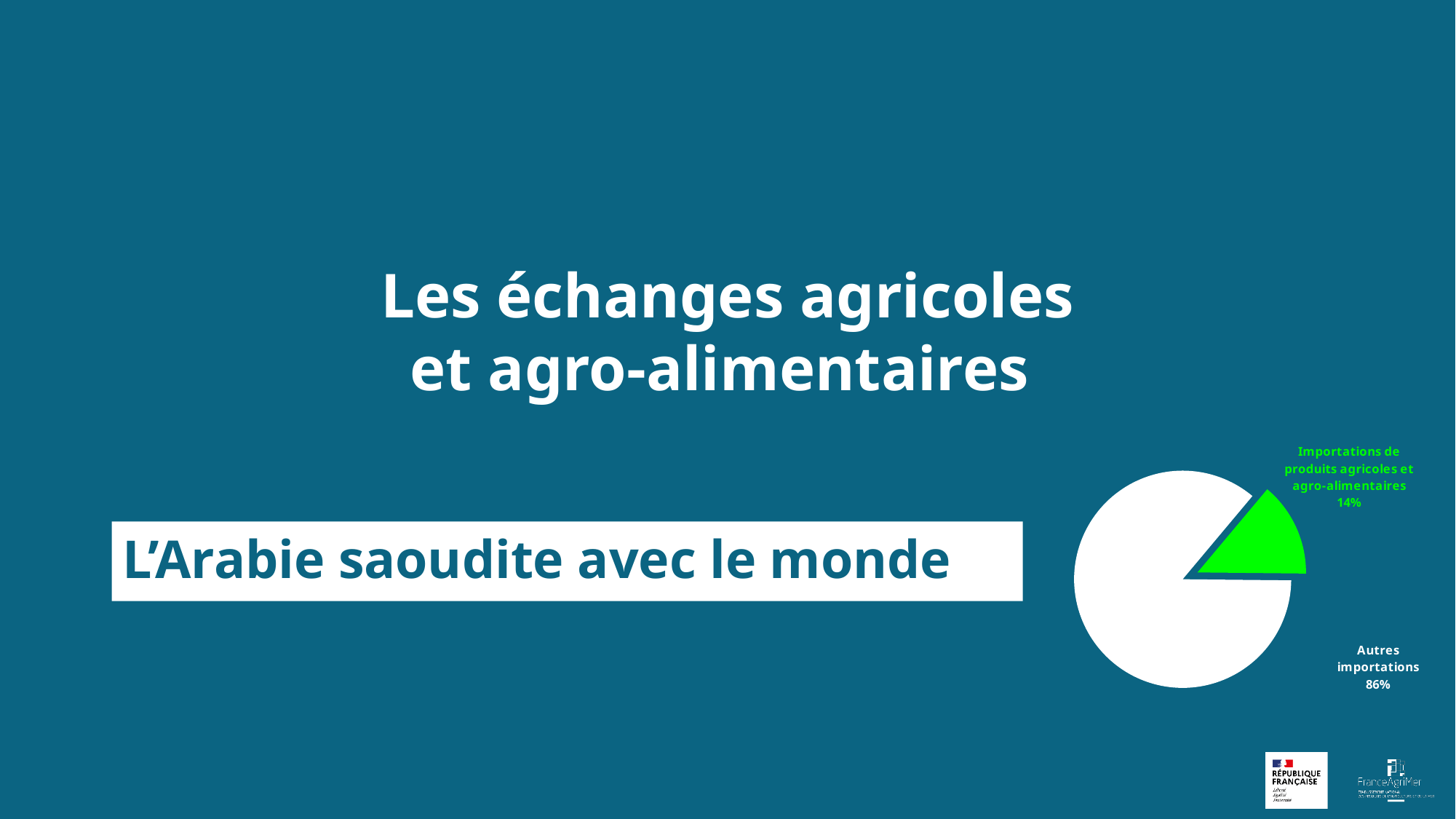
How many slices does the pie chart have? 2 What is the total of the two slices shown in the pie chart? 100% What colour is the slice for "Autres importations"? White What share of the pie is labelled "Importations de produits agricoles et agro-alimentaires"? 14% Which slice of the pie is the largest? Autres importations What kind of chart is shown on the slide? Pie chart Which is larger: "Autres importations" or "Importations de produits agricoles et agro-alimentaires"? Autres importations What colour is the slice for "Importations de produits agricoles et agro-alimentaires"? Green Which slice of the pie is the smallest? Importations de produits agricoles et agro-alimentaires What is the difference in percentage points between "Autres importations" and "Importations de produits agricoles et agro-alimentaires"? 72 percentage points What share of the pie is labelled "Autres importations"? 86%